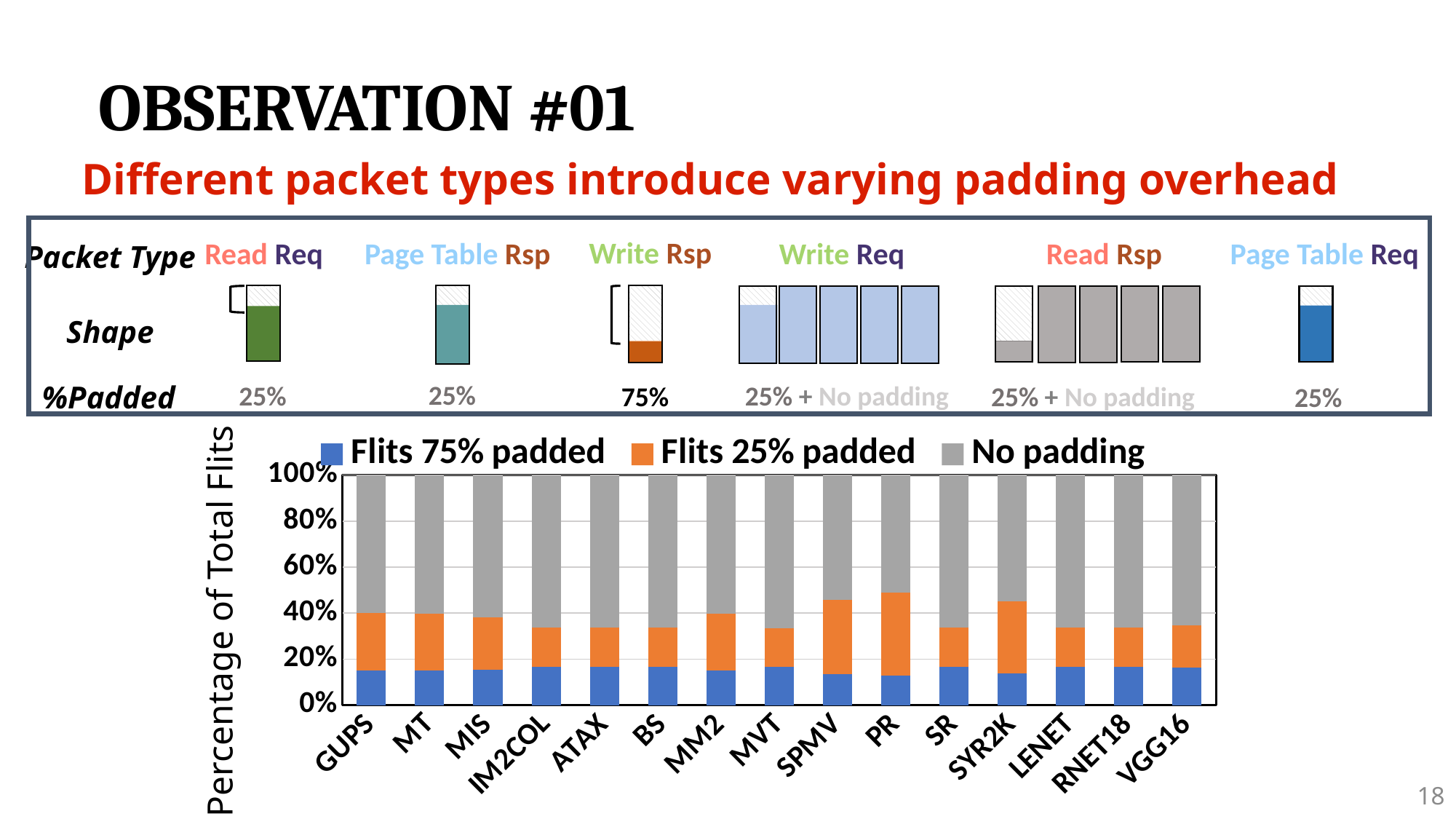
What is the label of the chart's y axis? Percentage of Total Flits Is the combined value of the padded segments for IM2COL greater or less than 40%? less What are the three series named in the chart legend? Flits 75% padded, Flits 25% padded, No padding Is the combined value of the padded segments (Flits 75% padded plus Flits 25% padded) for PR greater or less than 40%? greater Is the No padding segment for MVT greater or less than 60%? greater Which has a larger Flits 25% padded segment, PR or IM2COL? PR How many categories (workloads) are shown along the x axis of the chart? 15 What kind of chart is shown on the slide? Stacked bar chart What is the total of the stacked bar for GUPS? 100% How many series does the chart legend list? 3 Which has a larger No padding segment, MVT or SPMV? MVT